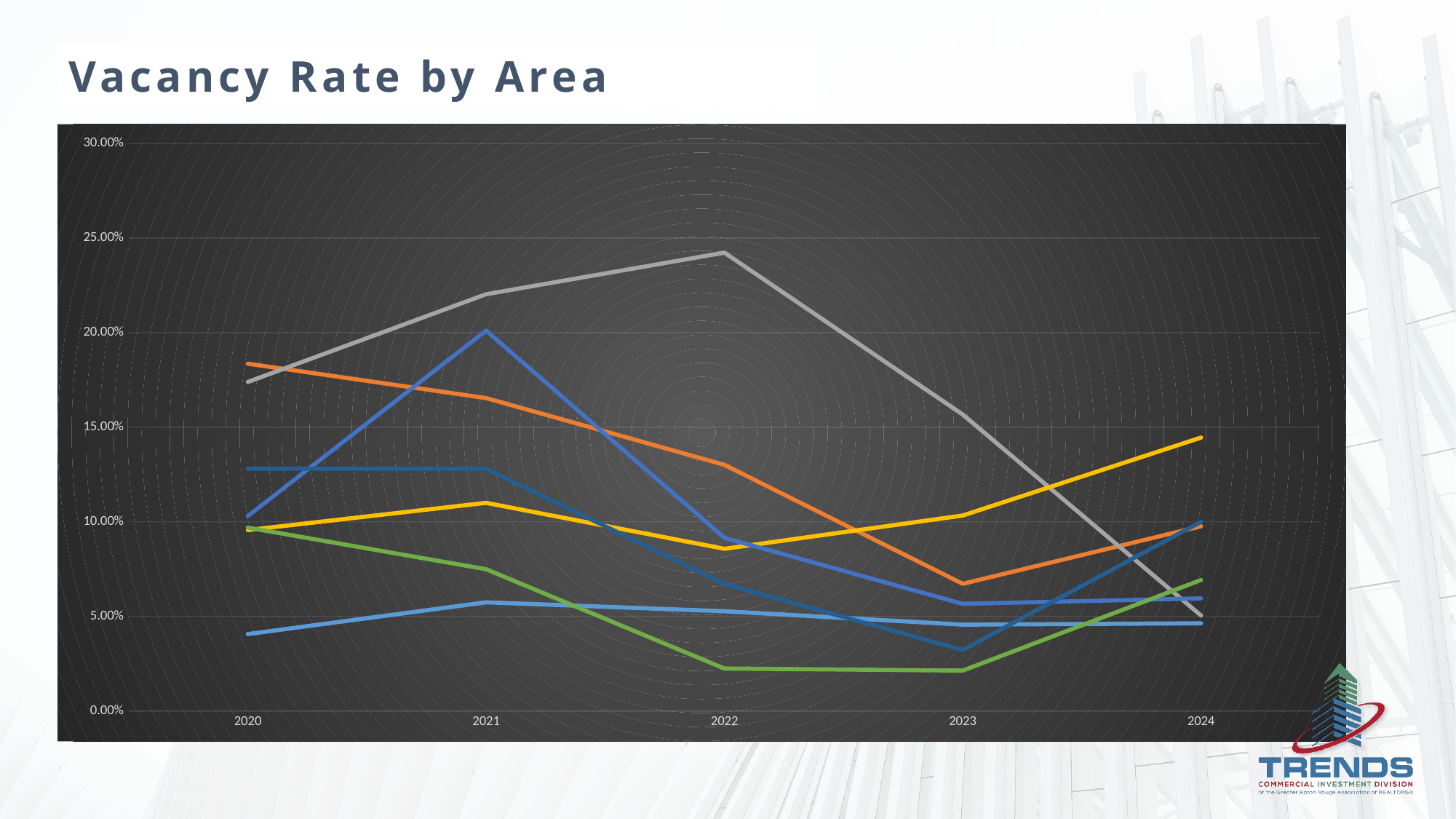
Is the value of the grey line in 2022 greater or less than 20%? greater In which year does the grey line reach its highest value? 2022 What is the title of the chart? Vacancy Rate by Area Is the value of the orange line in 2020 greater or less than 15%? greater In 2024, which is larger: the yellow line or the green line? the yellow line How many years are shown on the x axis of the chart? 5 Does the grey line rise or fall from 2022 to 2024? fall Is the value of the grey line in 2024 greater or less than 10%? less What kind of chart is shown on the slide? line chart In which year does the orange line reach its lowest value? 2023 What is the highest value shown on the y axis of the chart? 30.00%